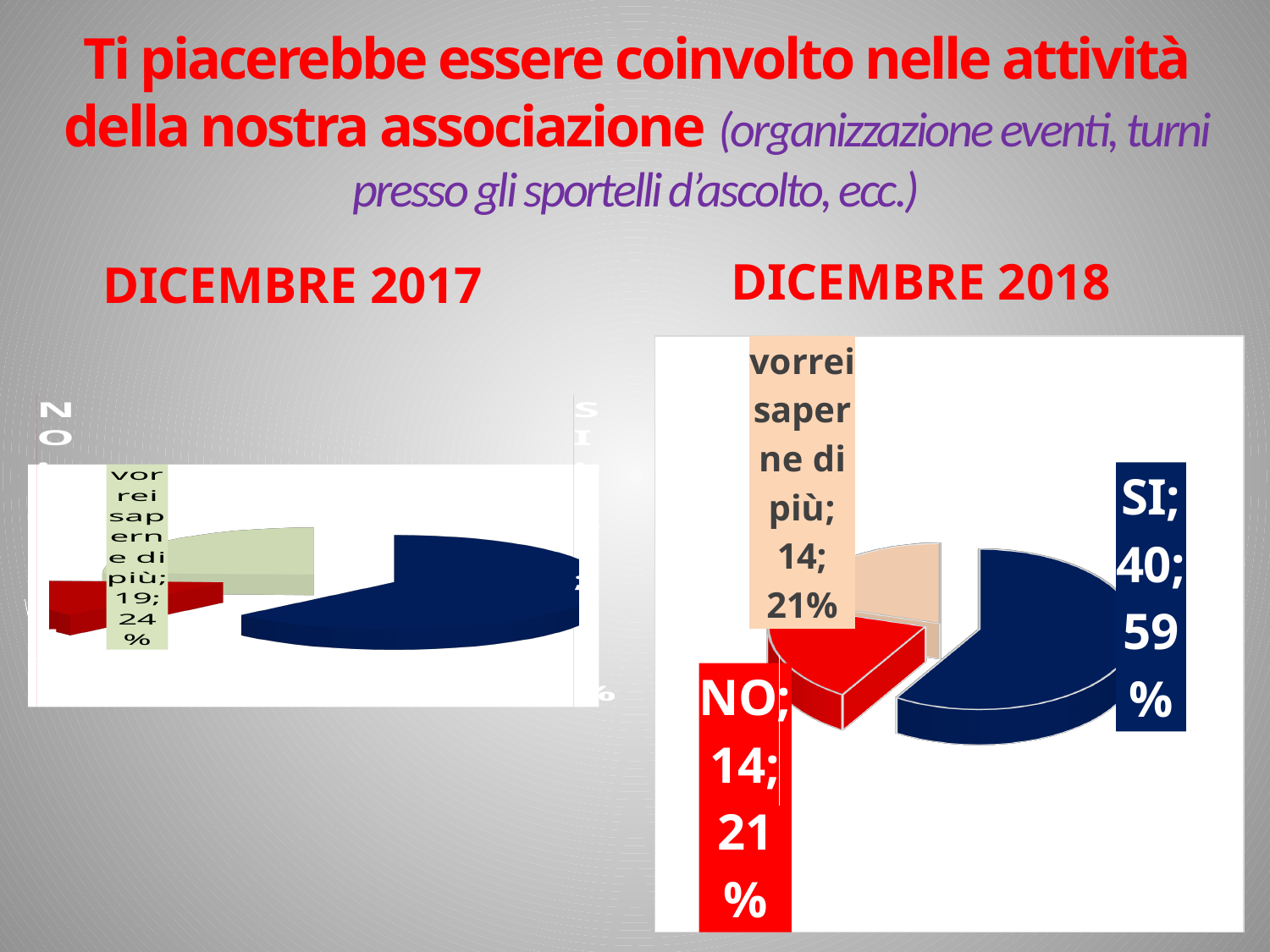
In the DICEMBRE 2018 chart, which category has the largest slice? SI How many slices does the DICEMBRE 2018 chart have? 3 What kind of chart is the DICEMBRE 2018 chart? Pie chart In the DICEMBRE 2018 chart, which is larger, the SI slice or the 'vorrei saperne di più' slice? SI In the DICEMBRE 2017 chart, what is the count value shown for 'vorrei saperne di più'? 19 In the DICEMBRE 2017 chart, what percentage share does the 'vorrei saperne di più' slice have? 24% In the DICEMBRE 2018 chart, what percentage share does the 'vorrei saperne di più' slice have? 21% In the DICEMBRE 2018 chart, what percentage share does the NO slice have? 21% In the DICEMBRE 2018 chart, what is the difference between the SI count and the NO count? 26 In the DICEMBRE 2018 chart, what is the count value shown for SI? 40 In the DICEMBRE 2018 chart, what is the count value shown for NO? 14